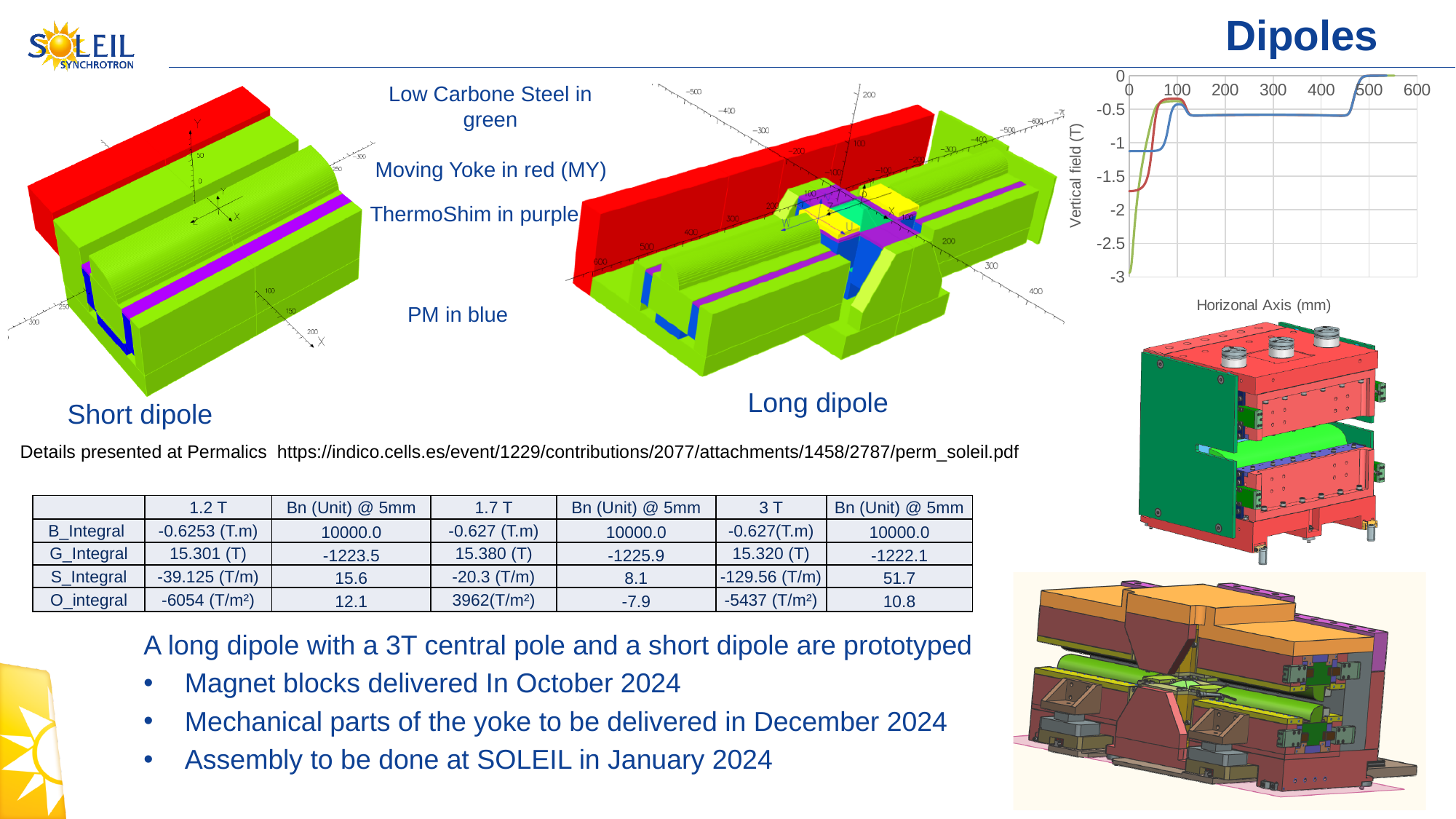
In the line chart, is the vertical field at 300 mm greater or less than -1? greater What is the x-axis title of the line chart at the top right? Horizonal Axis (mm) In the line chart, does the vertical field rise or fall as the horizontal axis goes from 450 mm to 500 mm? rise What is the y-axis title of the line chart at the top right? Vertical field (T) What is the largest value shown on the x axis of the line chart? 600 In the line chart, is the lowest vertical field plotted greater or less than -2.5? less What kind of chart is shown at the top right of the slide? line chart In the line chart, does the vertical field rise or fall as the horizontal axis goes from 0 mm to 100 mm? rise